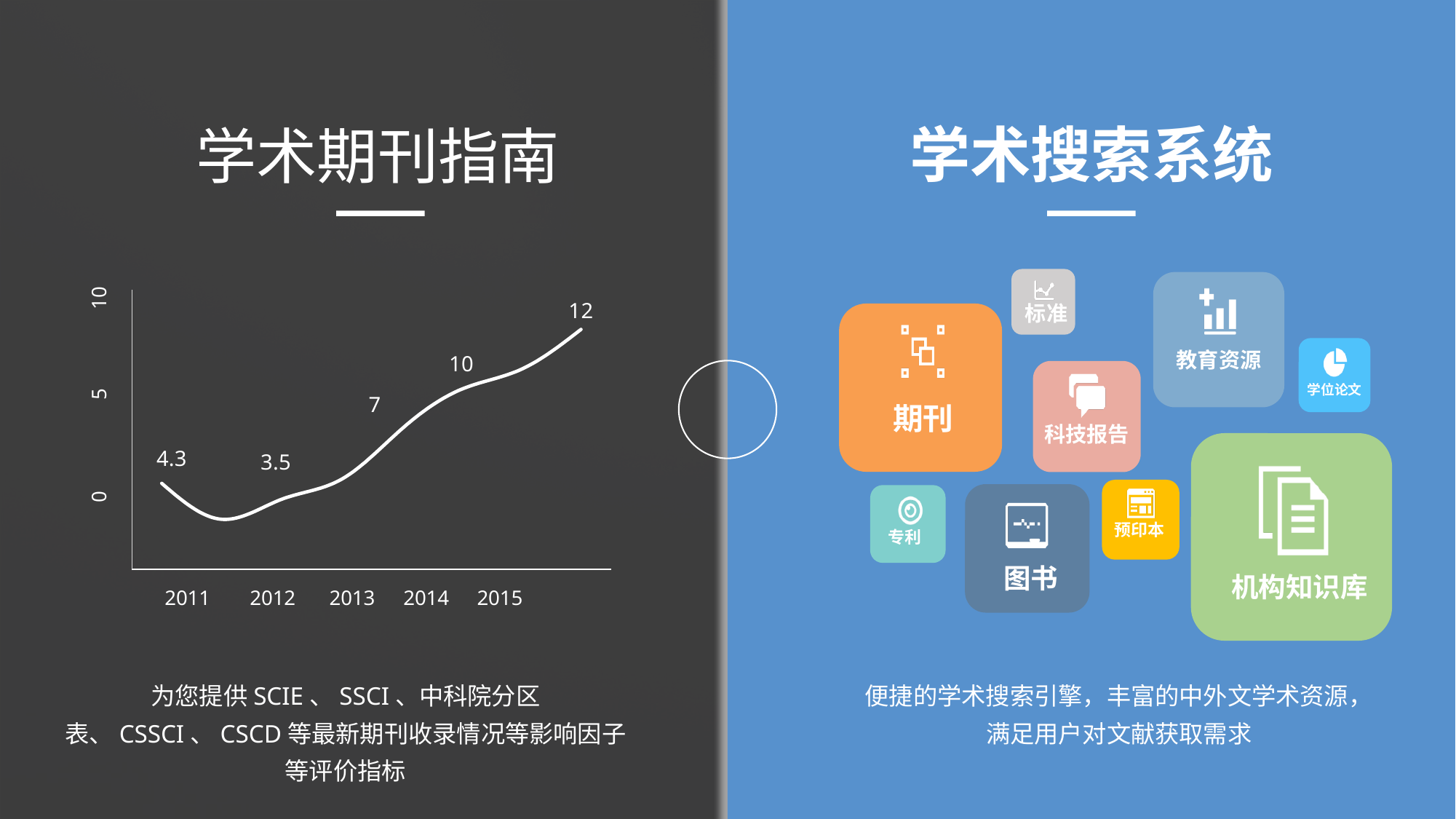
What type of chart is shown on the left side of the slide? line chart How many years are shown on the x axis of the line chart? 5 Do the labelled values in the line chart rise or fall from 2012 to 2015? rise